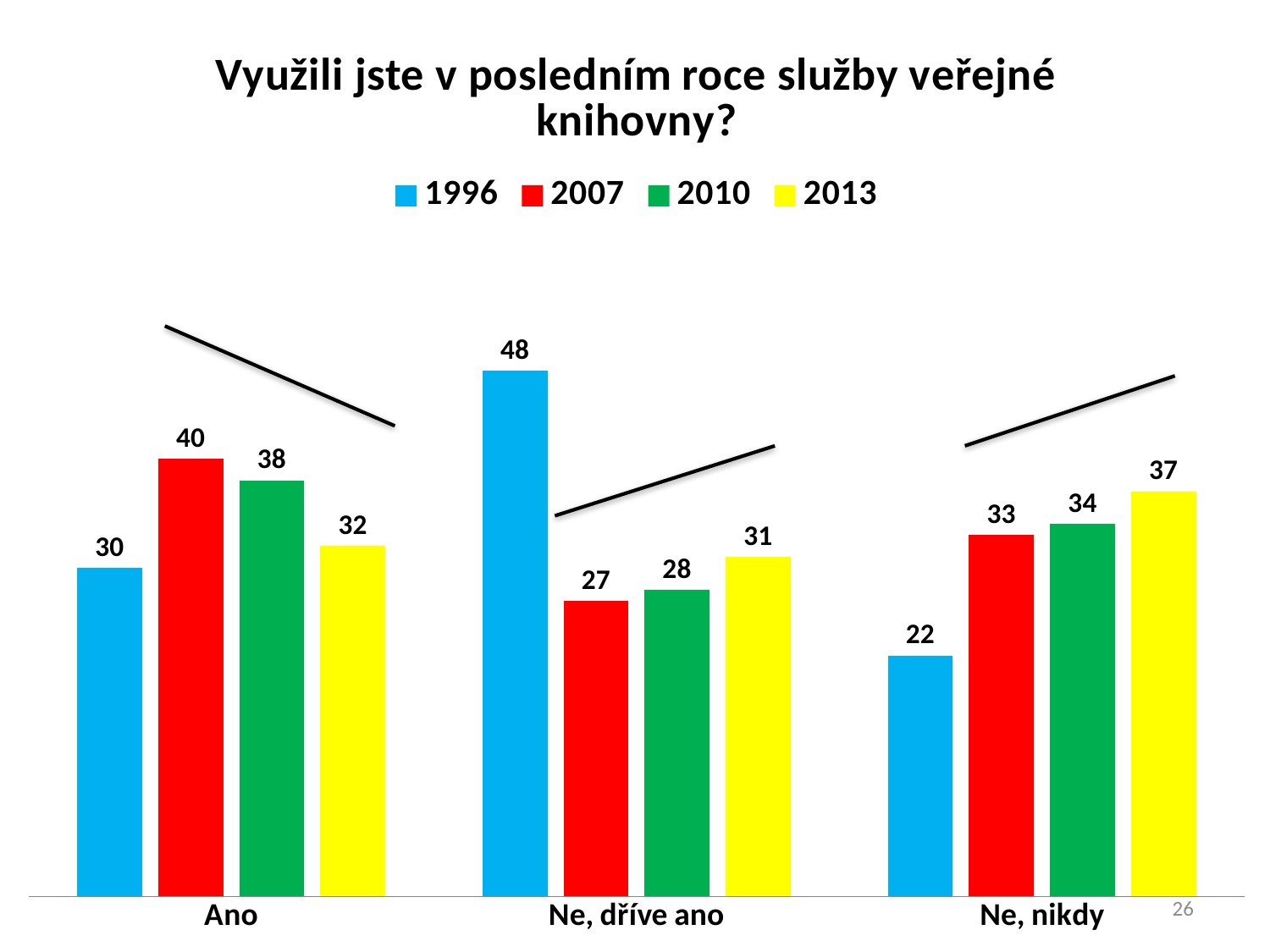
How many categories are shown on the x axis? 3 How many series does the legend list? 4 What is the value for 2013 in the "Ne, nikdy" category? 37 Which is larger in the "Ano" category: the value for 2010 or the value for 2013? 2010 What colour represents the 2013 series in the legend? yellow What is the value for 2007 in the "Ano" category? 40 Which year has the highest value in the "Ne, dříve ano" category? 1996 In the "Ne, nikdy" category, do the values rise or fall from 1996 to 2013? rise What kind of chart is shown on the slide? bar chart What is the difference between the 1996 and 2013 values in the "Ne, dříve ano" category? 17 What is the value for 1996 in the "Ne, dříve ano" category? 48 Which year has the lowest value in the "Ne, nikdy" category? 1996